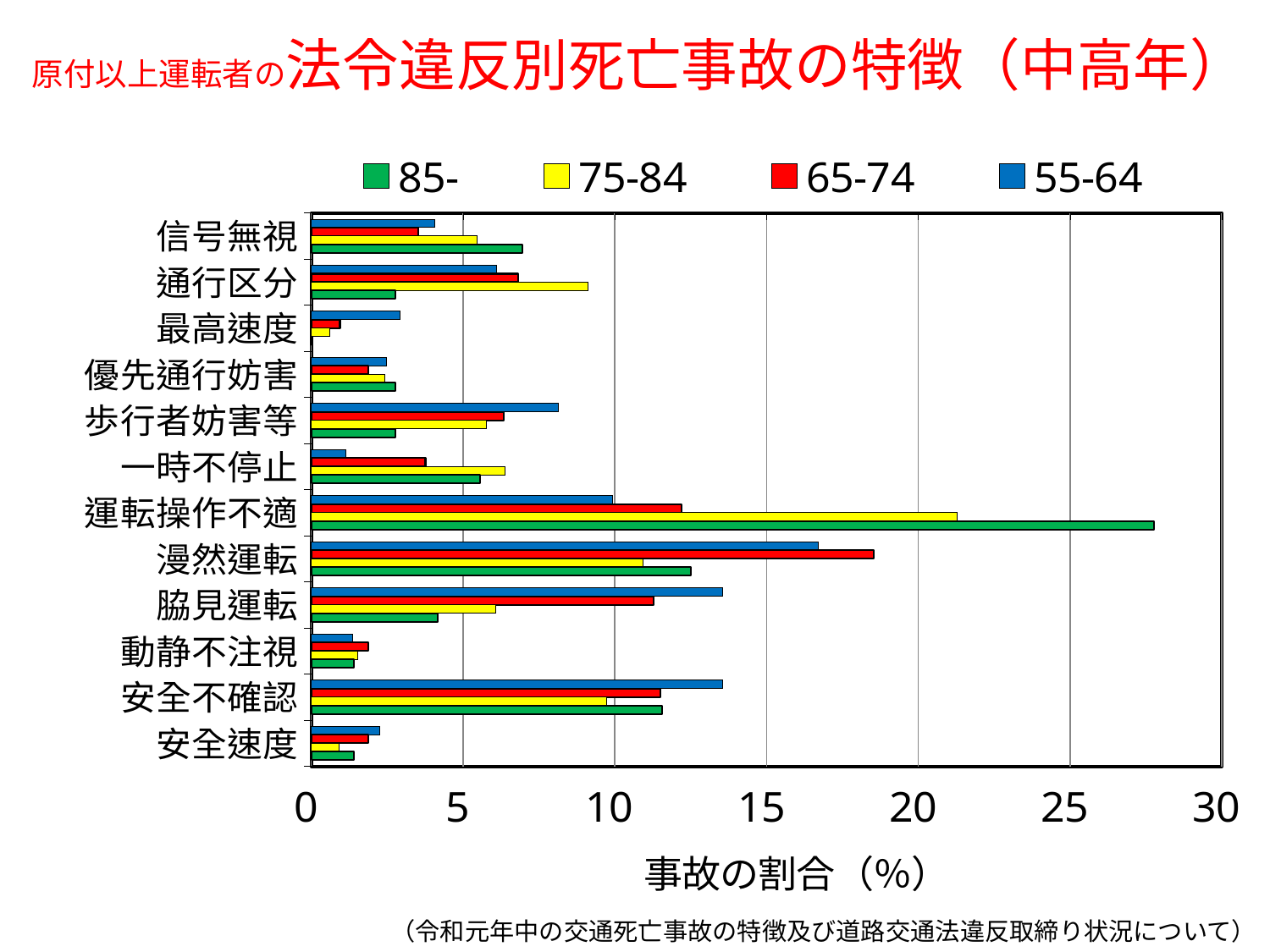
For 通行区分, which series has the larger value: 75-84 or 85-? 75-84 For 漫然運転, which series has the larger value: 65-74 or 75-84? 65-74 For 信号無視, which series has the highest value? 85- Is the value for 歩行者妨害等 in the 55-64 series greater or less than 10? less For the 55-64 series, which category has the highest value? 漫然運転 Is the value for 運転操作不適 in the 75-84 series greater or less than 20? greater For the 85- series, which category has the highest value? 運転操作不適 What kind of chart is shown on the slide? bar chart How many series does the legend list? 4 What is the title of the x axis? 事故の割合（%） Is the value for 運転操作不適 in the 85- series greater or less than 25? greater How many violation categories are plotted on the y axis? 12